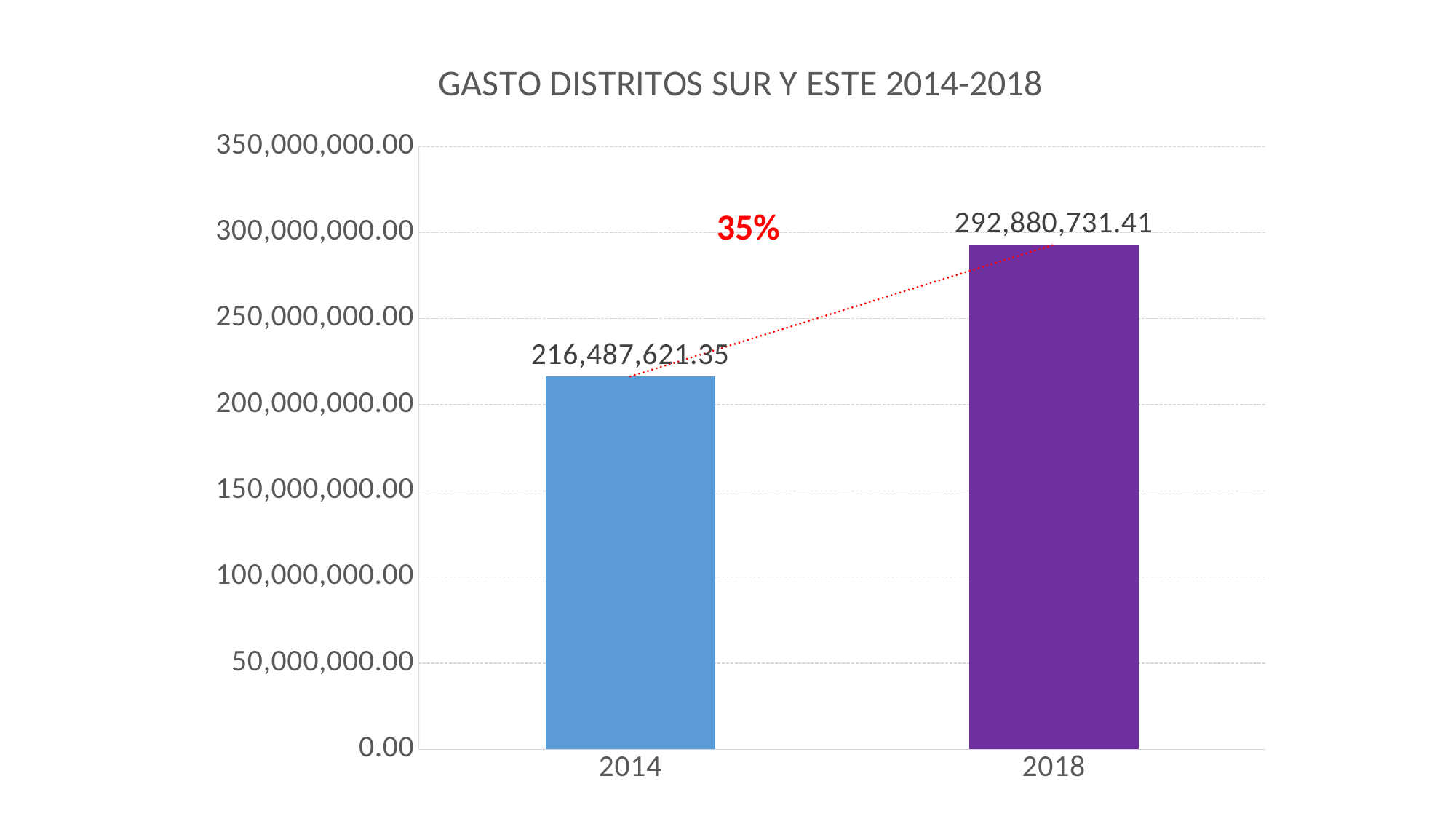
What is the value for 2014? 216,487,621.35 How many bars are shown in the chart? 2 What is the title of the chart? GASTO DISTRITOS SUR Y ESTE 2014-2018 Which year has the higher value? 2018 What kind of chart is shown on the slide? Bar chart Is the value for 2018 greater or less than 250,000,000.00? greater What is the value for 2018? 292,880,731.41 Is the value for 2014 greater or less than 250,000,000.00? less What percentage is shown in red between the two bars? 35% What is the difference between the 2018 value and the 2014 value? 76,393,110.06 Which year has the lower value? 2014 Do the values rise or fall from 2014 to 2018? Rise